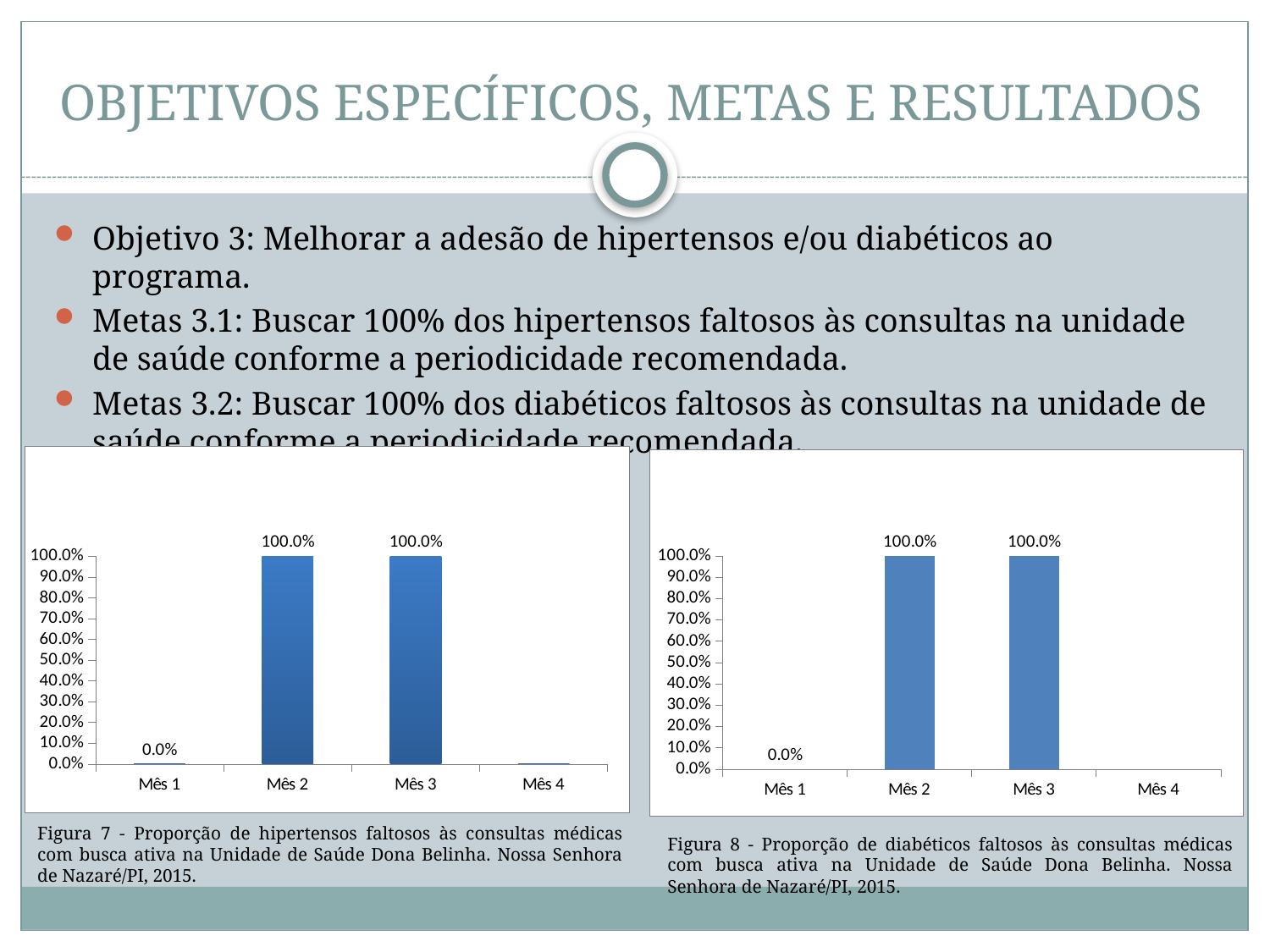
In the left chart (Figura 7), what is the value for Mês 1? 0.0% In the left chart (Figura 7), is the value for Mês 3 greater or less than 50.0%? greater According to its caption, what does the right chart (Figura 8) show the proportion of? diabéticos faltosos às consultas médicas com busca ativa In the right chart (Figura 8), what is the value for Mês 1? 0.0% In the left chart (Figura 7), which category has the lowest labelled value? Mês 1 In the right chart (Figura 8), which is larger, the value for Mês 1 or the value for Mês 2? Mês 2 In the left chart (Figura 7), what is the value for Mês 2? 100.0% In the right chart (Figura 8), does the value rise or fall from Mês 1 to Mês 2? rise How many categories are shown on the x axis of the right chart (Figura 8)? 4 In the left chart (Figura 7), what is the difference between the values for Mês 2 and Mês 1? 100.0% What kind of chart is the left chart (Figura 7)? bar chart In the right chart (Figura 8), what is the value for Mês 3? 100.0%